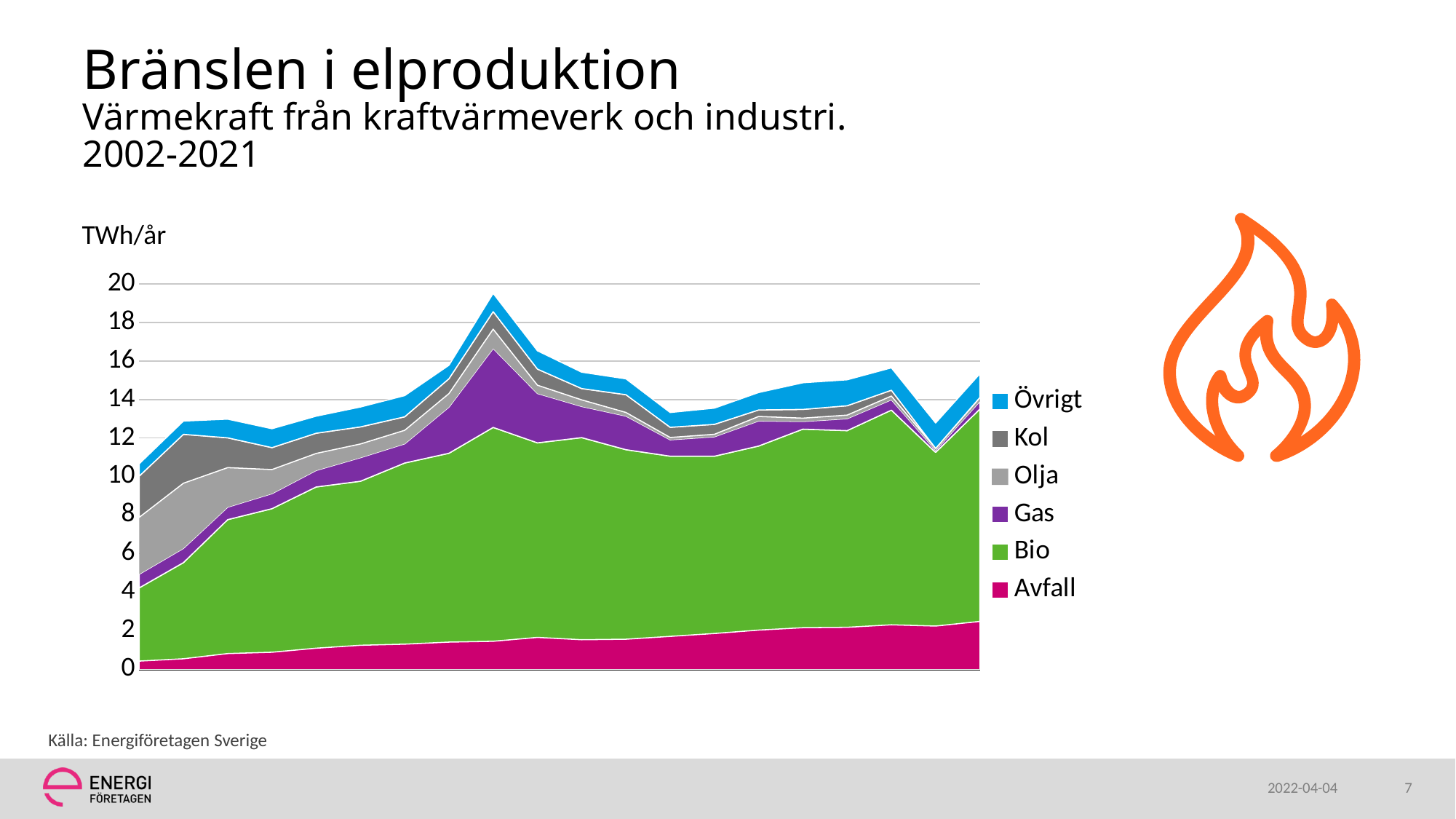
Which series are listed in the legend? Övrigt, Kol, Olja, Gas, Bio, Avfall Which series accounts for the largest share of the stacked total across the chart? Bio Is the Avfall value at the rightmost point of the chart greater or less than 4? less Is the stacked total at the leftmost point of the chart greater or less than 12? less What kind of chart is shown on the slide? Stacked area chart Which is larger at the leftmost point of the chart, the Bio value or the Avfall value? Bio Does the Avfall series rise or fall from the left to the right of the chart? Rises What unit is shown on the y axis of the chart? TWh/år Does the Kol series rise or fall from the left to the right of the chart? Falls Is the highest stacked total in the chart greater or less than 18? greater How many series does the legend list? 6